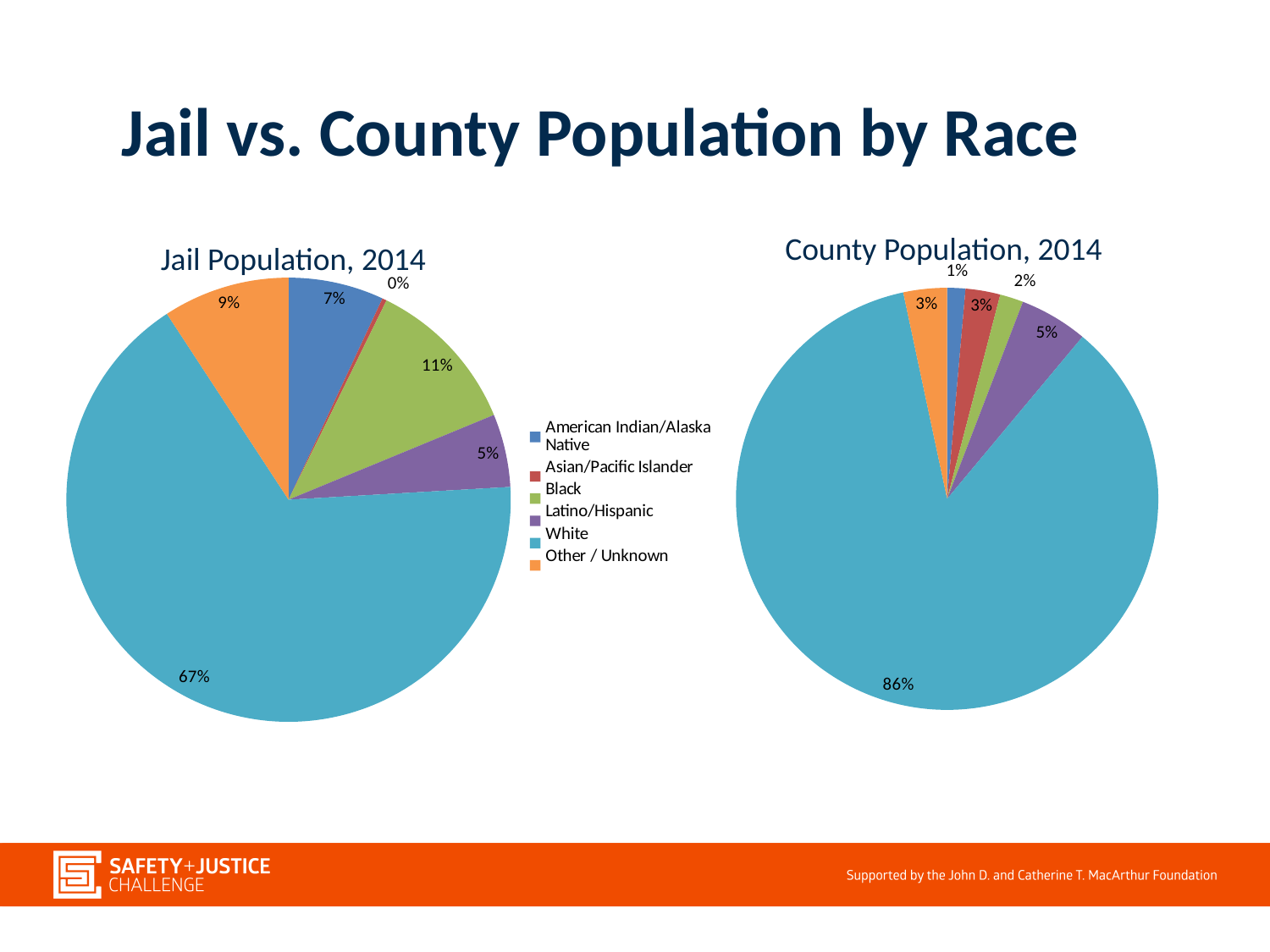
What type of chart is used on this slide? Pie chart In the County Population, 2014 chart, what share of the pie is White? 86% In the Jail Population, 2014 chart, what share of the pie is White? 67% In the Jail Population, 2014 chart, what percentage is shown for Other / Unknown? 9% In the Jail Population, 2014 chart, what percentage is shown for Black? 11% Is the Black share larger in the Jail Population, 2014 chart or the County Population, 2014 chart? Jail Population, 2014 How many categories does the legend list? 6 In the Jail Population, 2014 chart, which category has the largest slice? White In the Jail Population, 2014 chart, which category has the smallest slice? Asian/Pacific Islander What is the difference between the White share in the County Population, 2014 chart and the White share in the Jail Population, 2014 chart? 19 percentage points In the County Population, 2014 chart, which category has the smallest slice? American Indian/Alaska Native In the County Population, 2014 chart, what percentage is shown for Black? 2%